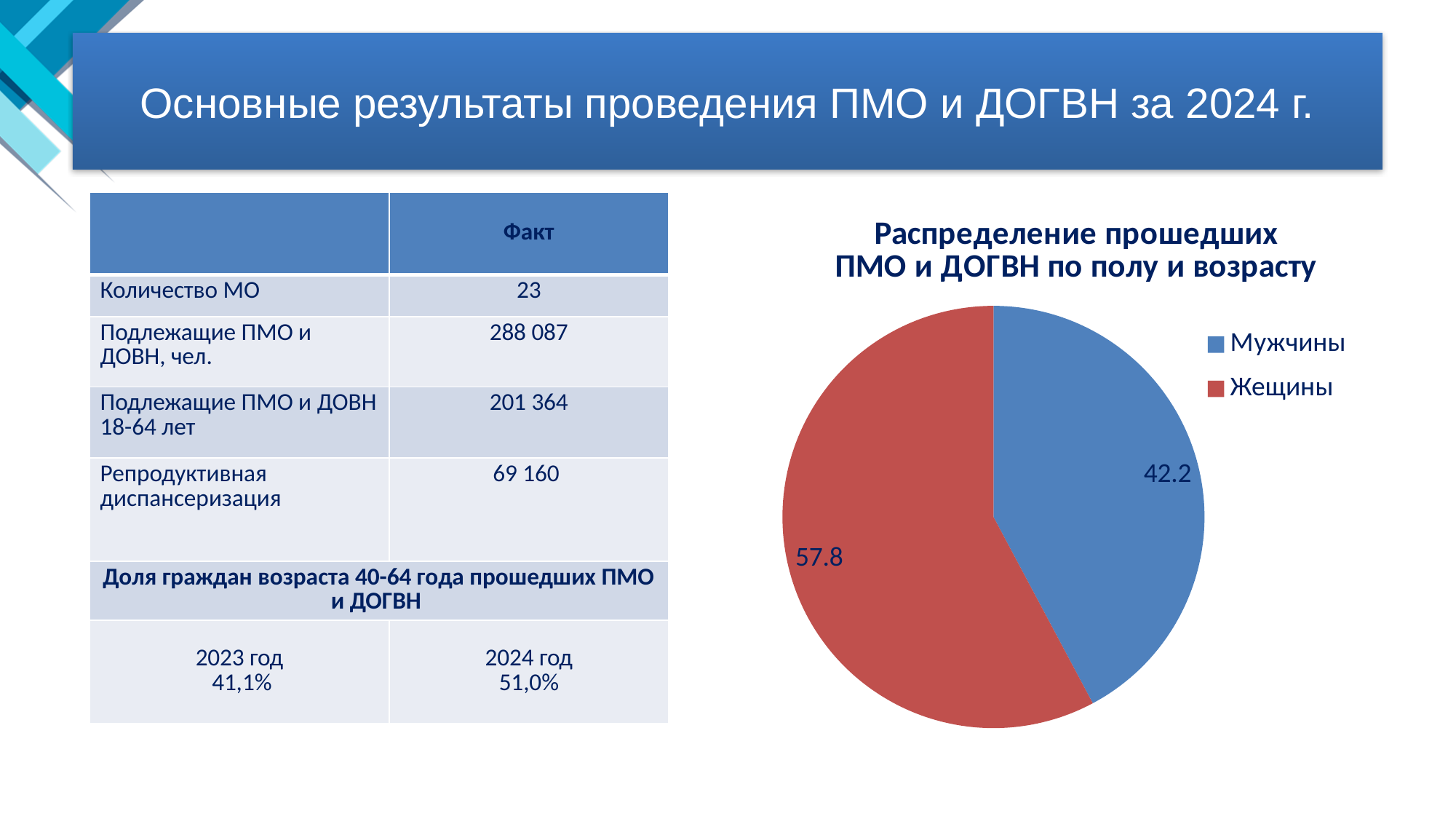
Which slice of the pie chart is the largest? Жещины What is the value for Жещины in the pie chart? 57.8 How many slices does the pie chart have? 2 Which slice of the pie chart is the smallest? Мужчины What kind of chart is shown on the slide? pie chart How many entries does the legend of the pie chart list? 2 What is the value for Мужчины in the pie chart? 42.2 What colour is the Мужчины slice in the pie chart? blue Which is larger in the pie chart, Мужчины or Жещины? Жещины What is the title of the pie chart? Распределение прошедших ПМО и ДОГВН по полу и возрасту What is the difference between the values for Жещины and Мужчины in the pie chart? 15.6